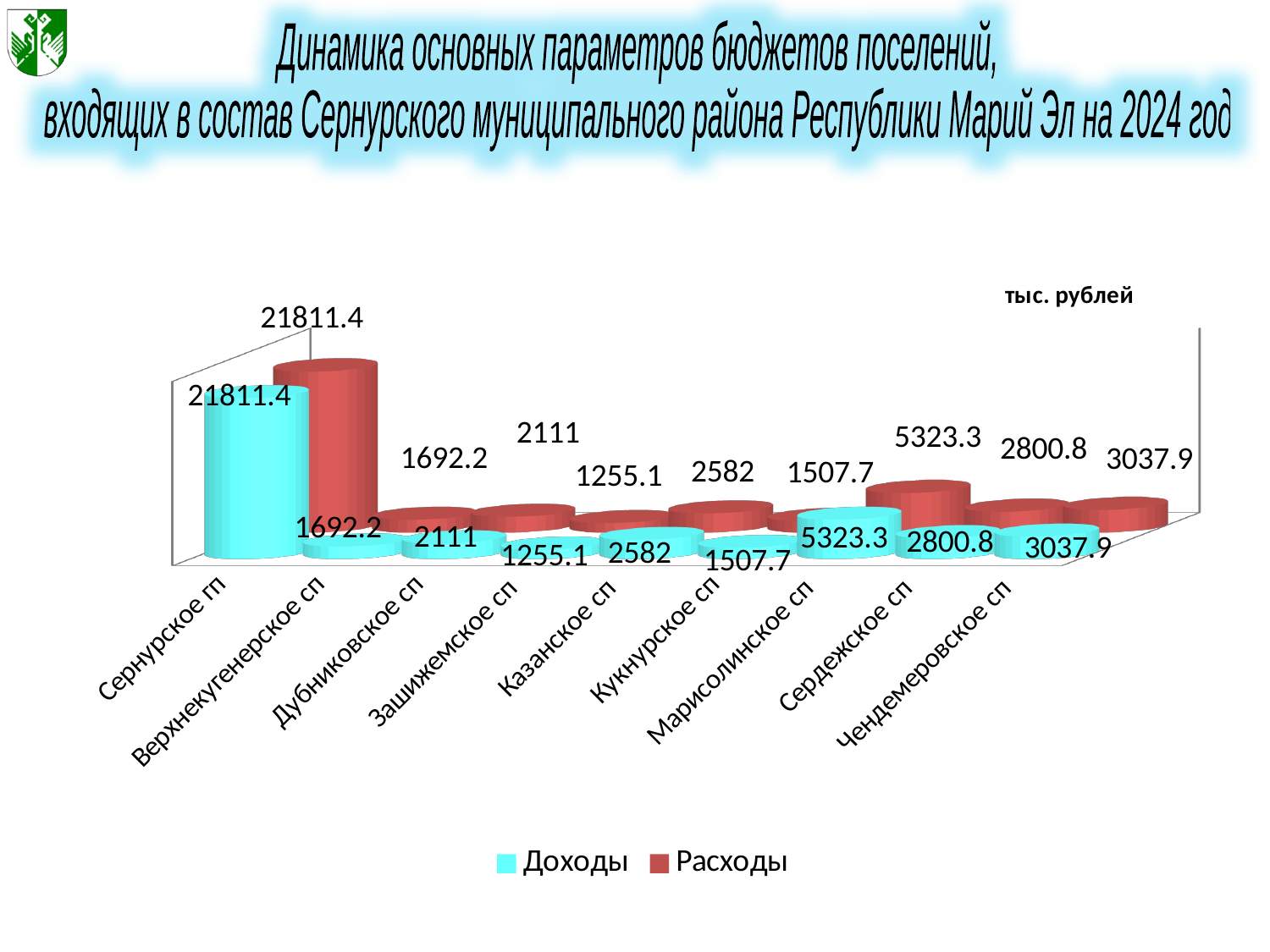
What kind of chart is shown on the slide? Bar chart Which has the larger Расходы value, Дубниковское сп or Кукнурское сп? Дубниковское сп What unit is indicated for the values in the chart? тыс. рублей Which category has the lowest Расходы value? Зашижемское сп What is the Доходы value for Сернурское гп? 21811.4 What is the Доходы value for Казанское сп? 2582 What is the Расходы value for Чендемеровское сп? 3037.9 What is the difference between the Доходы values for Сердежское сп and Чендемеровское сп? 237.1 How many series does the legend list? 2 Which category has the highest Доходы value? Сернурское гп What is the Расходы value for Сердежское сп? 2800.8 How many categories are shown on the x axis? 9